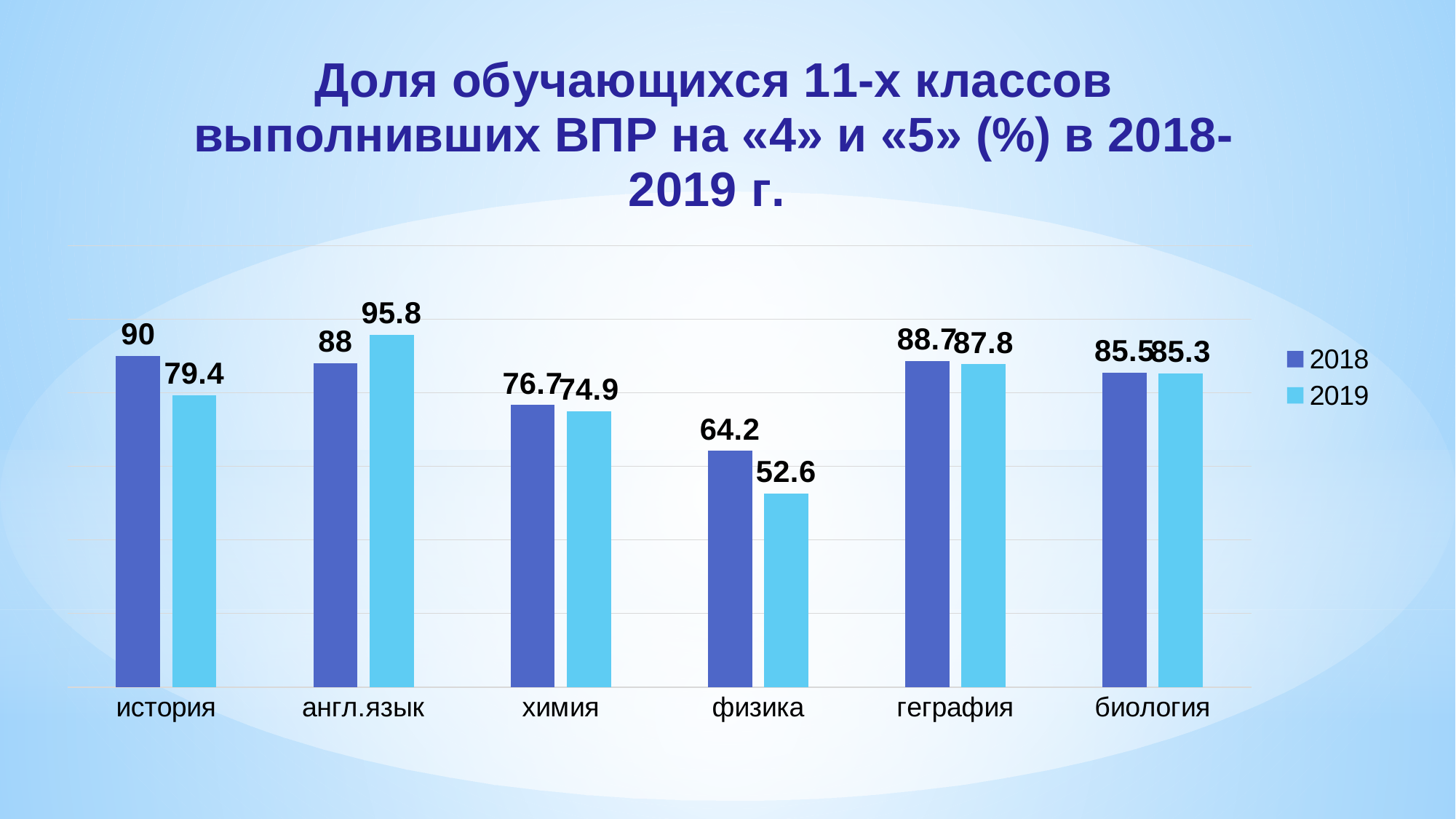
How many subjects are shown on the x axis? 6 How many series does the legend list? 2 What is the difference between the 2018 and 2019 values for история? 10.6 Which subject has the highest value in the 2019 series? англ.язык Which subject has the lowest value in the 2018 series? физика What is the value for физика in 2019? 52.6 What is the difference between the 2018 and 2019 values for физика? 11.6 What is the value for англ.язык in 2019? 95.8 What kind of chart is shown on the slide? bar chart What is the value for история in 2018? 90 What is the value for геграфия in 2018? 88.7 For химия, which year has the larger value, 2018 or 2019? 2018